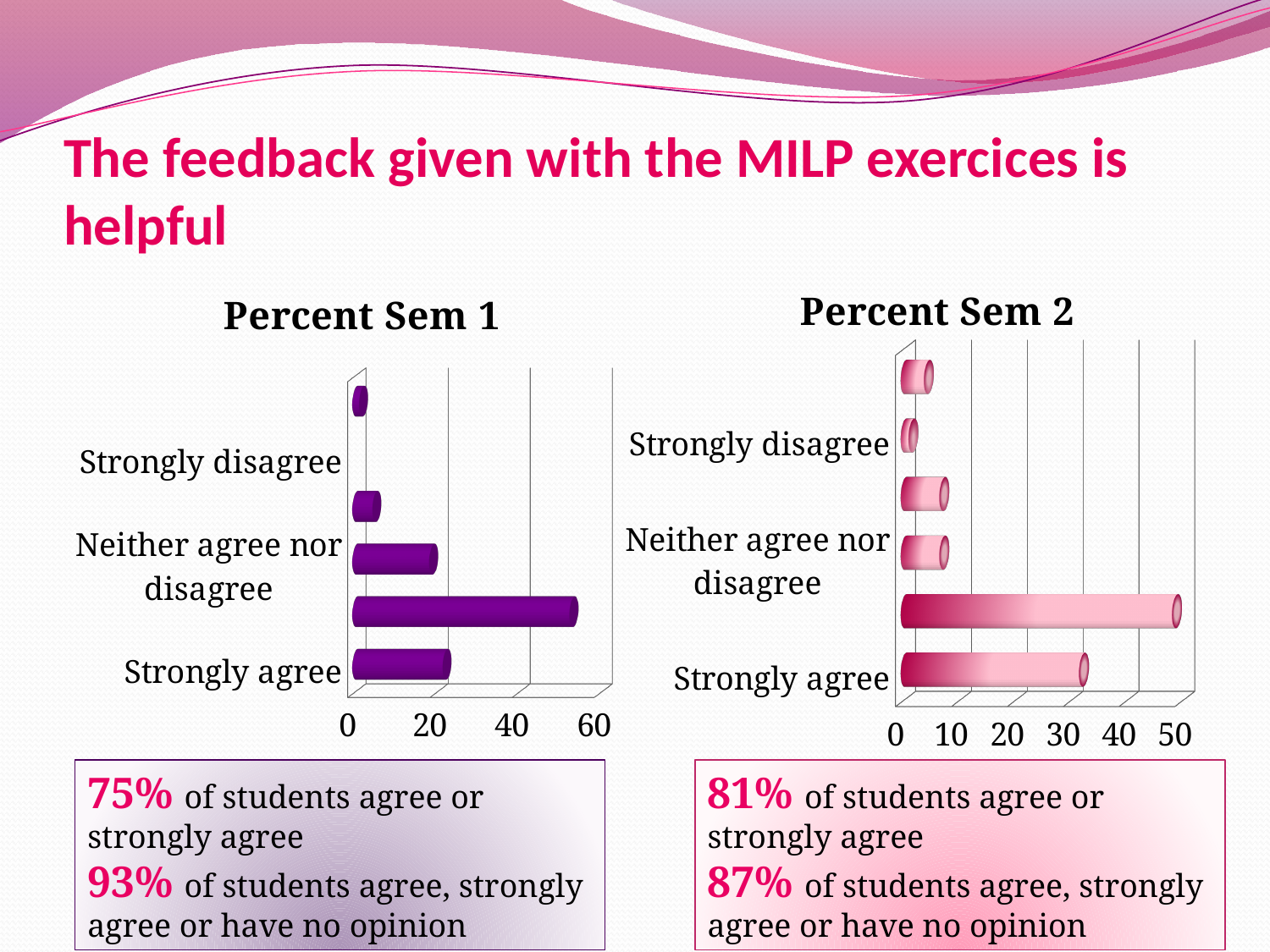
What kind of chart is the "Percent Sem 1" chart? bar chart In the "Percent Sem 2" chart, which labelled category has the lowest value? Strongly disagree In the "Percent Sem 2" chart, is the value for Neither agree nor disagree greater or less than 10? less How many bars does the "Percent Sem 2" chart show? 6 In the "Percent Sem 1" chart, which is larger, the value for Strongly agree or the value for Strongly disagree? Strongly agree What is the title of the chart on the right of the slide? Percent Sem 2 In the "Percent Sem 1" chart, which labelled category has the lowest value? Strongly disagree In the "Percent Sem 2" chart, which is larger, the value for Strongly agree or the value for Neither agree nor disagree? Strongly agree What is the highest value shown on the x axis of the "Percent Sem 1" chart? 60